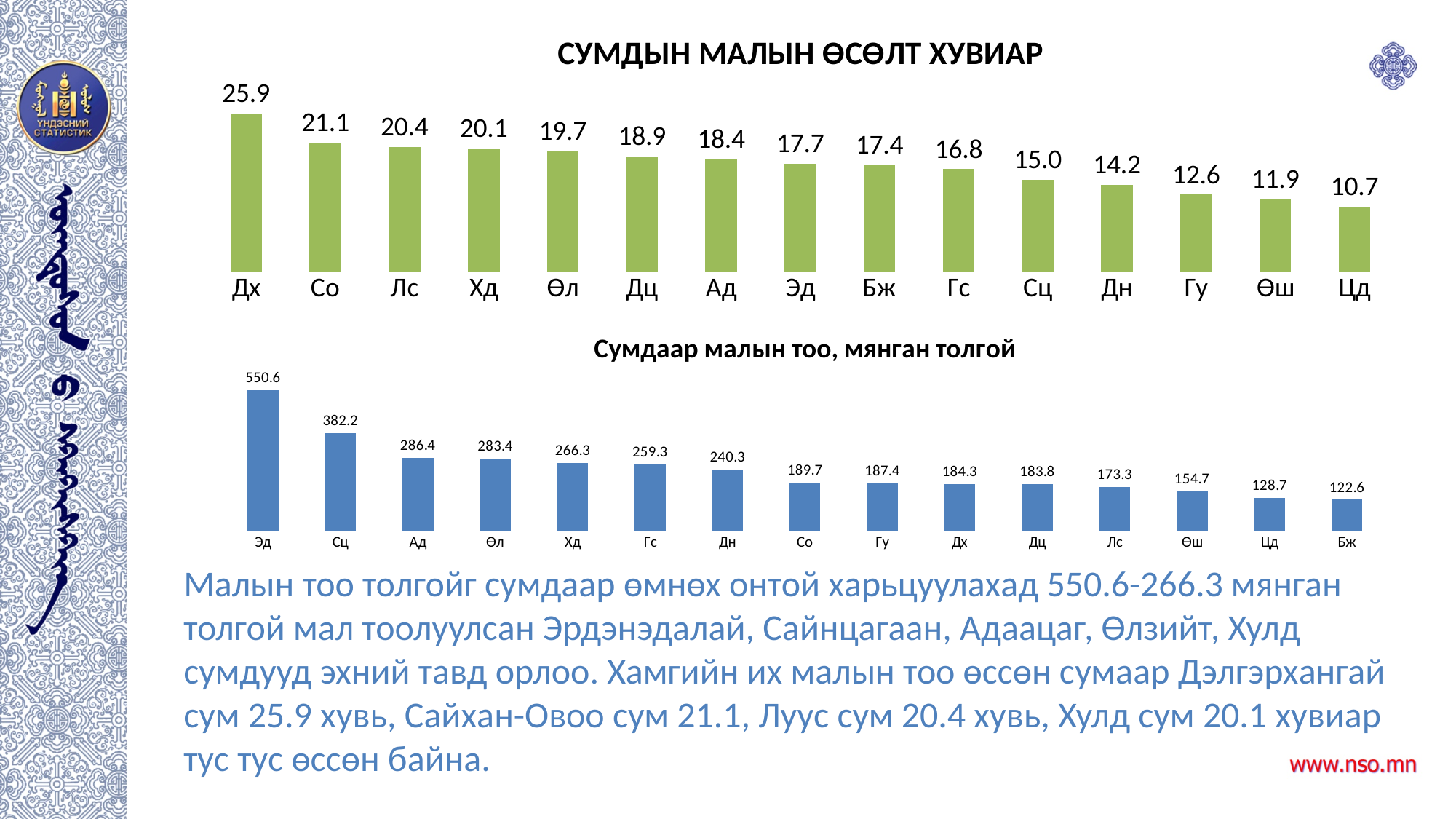
In the chart titled 'Сумдаар малын тоо, мянган толгой', what is the value for Эд? 550.6 In the chart titled 'Сумдаар малын тоо, мянган толгой', which category has the lowest value? Бж In the chart titled 'Сумдаар малын тоо, мянган толгой', what is the difference between the values for Эд and Сц? 168.4 In the chart titled 'СУМДЫН МАЛЫН ӨСӨЛТ ХУВИАР', what is the difference between the values for Дх and Со? 4.8 In the chart titled 'Сумдаар малын тоо, мянган толгой', which is larger, the value for Сц or the value for Ад? Сц In the chart titled 'СУМДЫН МАЛЫН ӨСӨЛТ ХУВИАР', which category has the lowest value? Цд In the chart titled 'СУМДЫН МАЛЫН ӨСӨЛТ ХУВИАР', what is the value for Дх? 25.9 In the chart titled 'СУМДЫН МАЛЫН ӨСӨЛТ ХУВИАР', do the values rise or fall from left to right? fall In the chart titled 'СУМДЫН МАЛЫН ӨСӨЛТ ХУВИАР', what is the value for Гс? 16.8 In the chart titled 'Сумдаар малын тоо, мянган толгой', which category has the highest value? Эд What kind of chart is the chart titled 'Сумдаар малын тоо, мянган толгой'? bar chart In the chart titled 'СУМДЫН МАЛЫН ӨСӨЛТ ХУВИАР', how many categories are shown on the x axis? 15